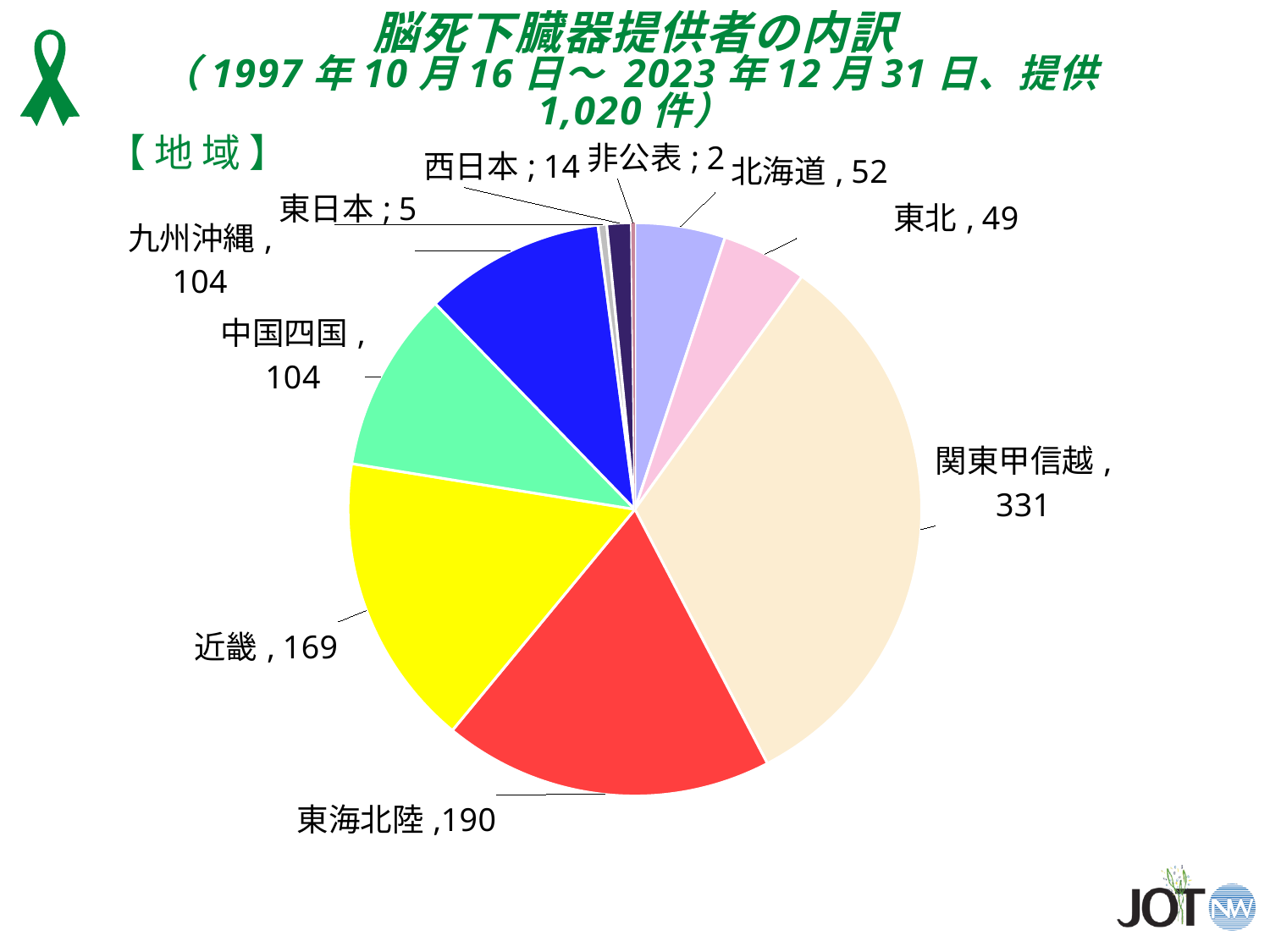
What is the difference between the values for 東海北陸 and 近畿? 21 What colour is the slice for 近畿? yellow Which category has the smallest slice in the pie chart? 非公表 What type of chart is shown on the slide? pie chart What value is shown for 西日本 in the pie chart? 14 What value is shown for 関東甲信越 in the pie chart? 331 What value is shown for 北海道 in the pie chart? 52 What value is shown for 東海北陸 in the pie chart? 190 Which is larger, the value for 北海道 or the value for 東北? 北海道 What is the total number of cases (提供件数) stated in the slide title? 1,020 件 How many categories (slices) does the pie chart have? 10 Which region has the largest slice in the pie chart? 関東甲信越